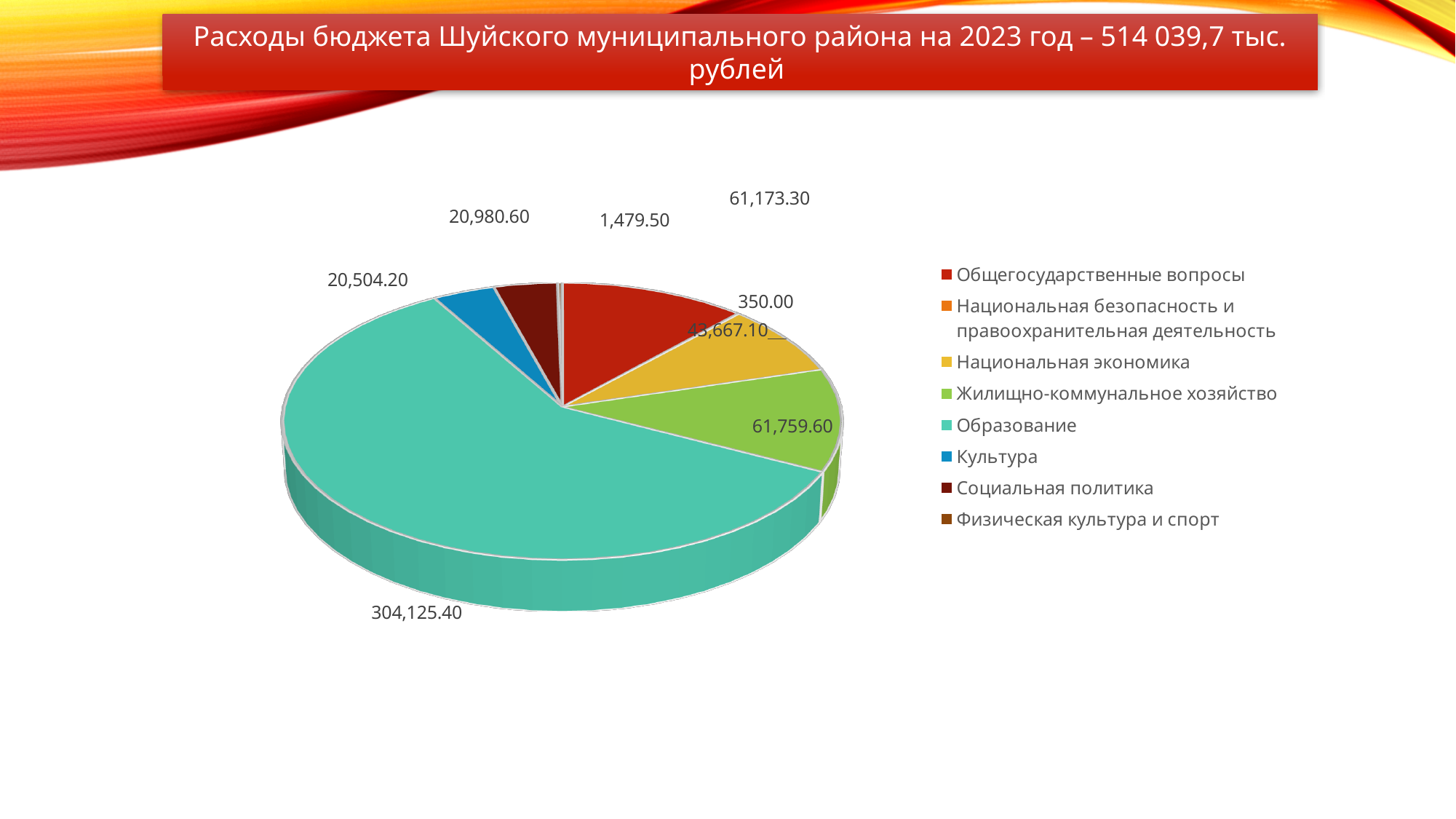
What is the value for Национальная экономика? 43,667.10 What is the difference between Жилищно-коммунальное хозяйство and Общегосударственные вопросы? 586.30 What kind of chart is shown on the slide? Pie chart What is the difference between Социальная политика and Культура? 476.40 What is the value for Общегосударственные вопросы? 61,173.30 Which category has the smallest slice? Национальная безопасность и правоохранительная деятельность Which is larger, Образование or Жилищно-коммунальное хозяйство? Образование Which category has the largest slice? Образование What is the value for Образование? 304,125.40 How many categories does the legend list? 8 What is the value for Физическая культура и спорт? 1,479.50 What is the value for Культура? 20,504.20